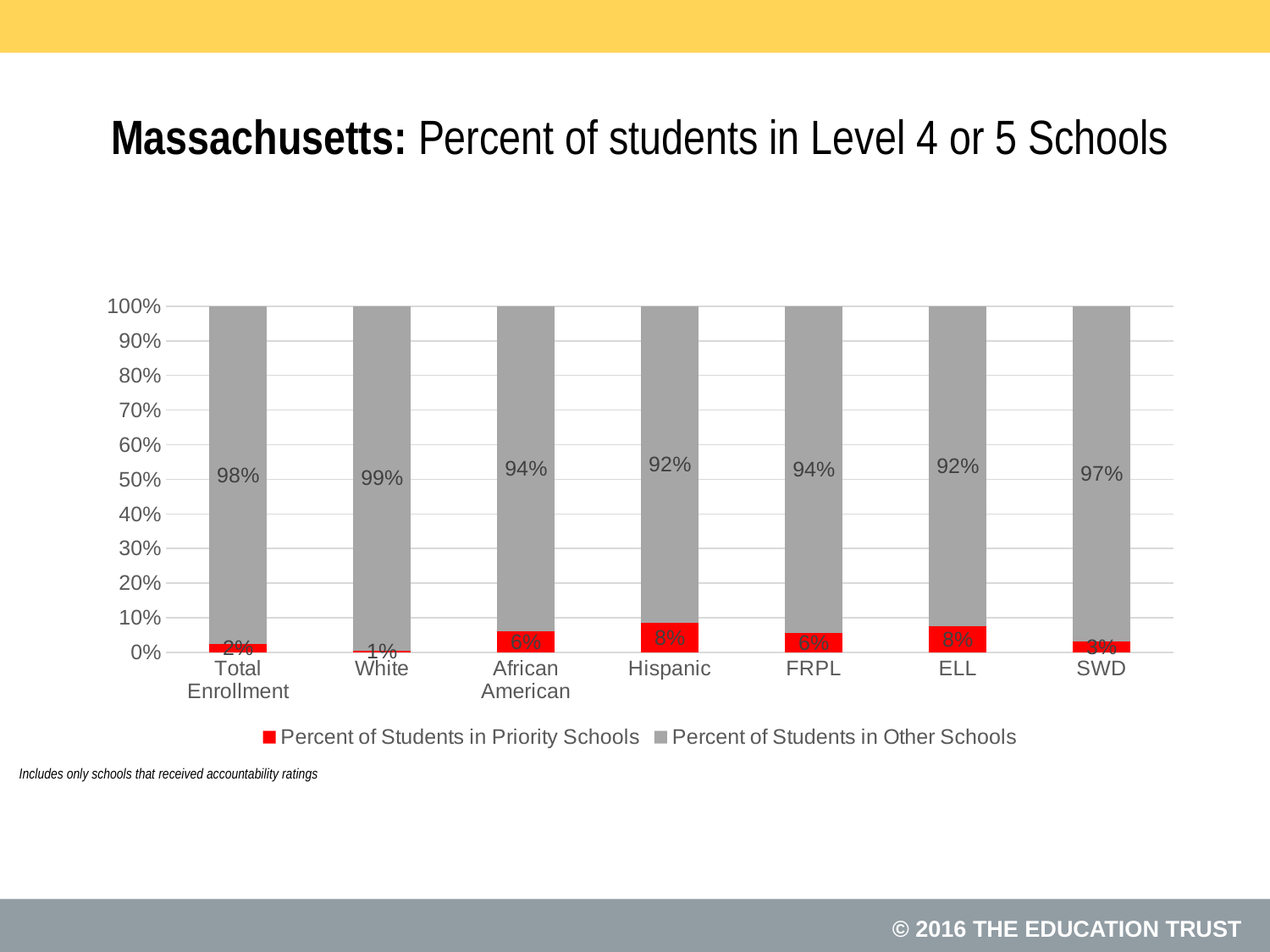
What kind of chart is shown on the slide? Stacked bar chart How many series does the legend list? 2 How many categories are shown on the x axis? 7 Which is larger: the percent of African American students in Priority Schools or the percent of SWD students in Priority Schools? African American What percent of Hispanic students are in Priority Schools? 8% What percent of FRPL students are in Other Schools? 94% Which colour represents Percent of Students in Priority Schools? Red Which category has the highest percent of students in Other Schools? White What percent of White students are in Other Schools? 99% Which category has the lowest percent of students in Priority Schools? White What is the difference between the percent of ELL students and the percent of Total Enrollment students in Priority Schools? 6% What percent of SWD students are in Priority Schools? 3%